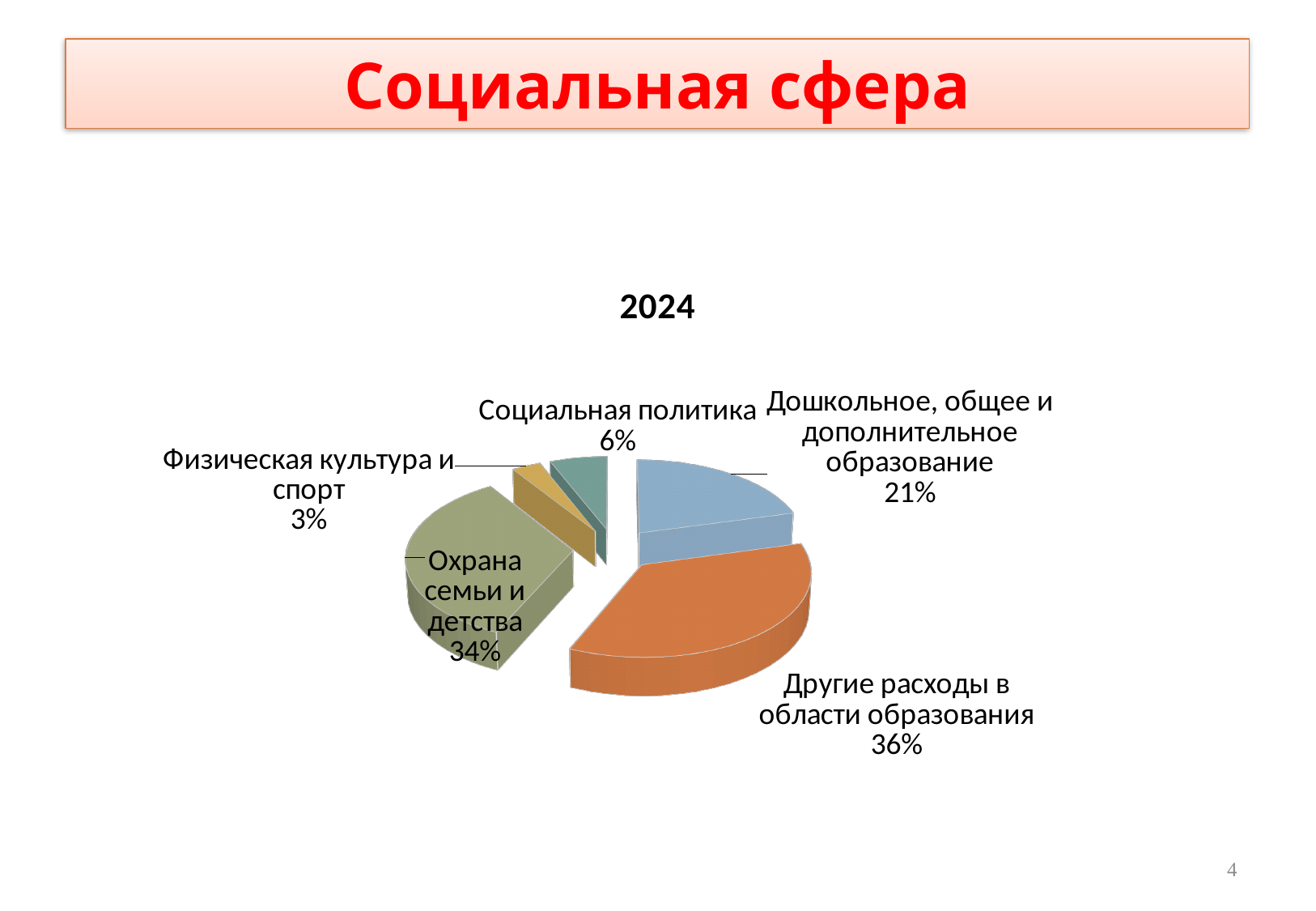
How many categories are shown in the pie chart? 5 Which is larger: the share of "Социальная политика" or "Физическая культура и спорт"? Социальная политика What type of chart is shown on the slide? Pie chart What share does "Социальная политика" have? 6% What share does "Охрана семьи и детства" have? 34% What share does "Дошкольное, общее и дополнительное образование" have? 21% What share does "Другие расходы в области образования" have? 36% What is the chart's title? 2024 What share does "Физическая культура и спорт" have? 3% Which category has the largest share? Другие расходы в области образования Which category has the smallest share? Физическая культура и спорт What is the difference between the shares of "Другие расходы в области образования" and "Дошкольное, общее и дополнительное образование"? 15%